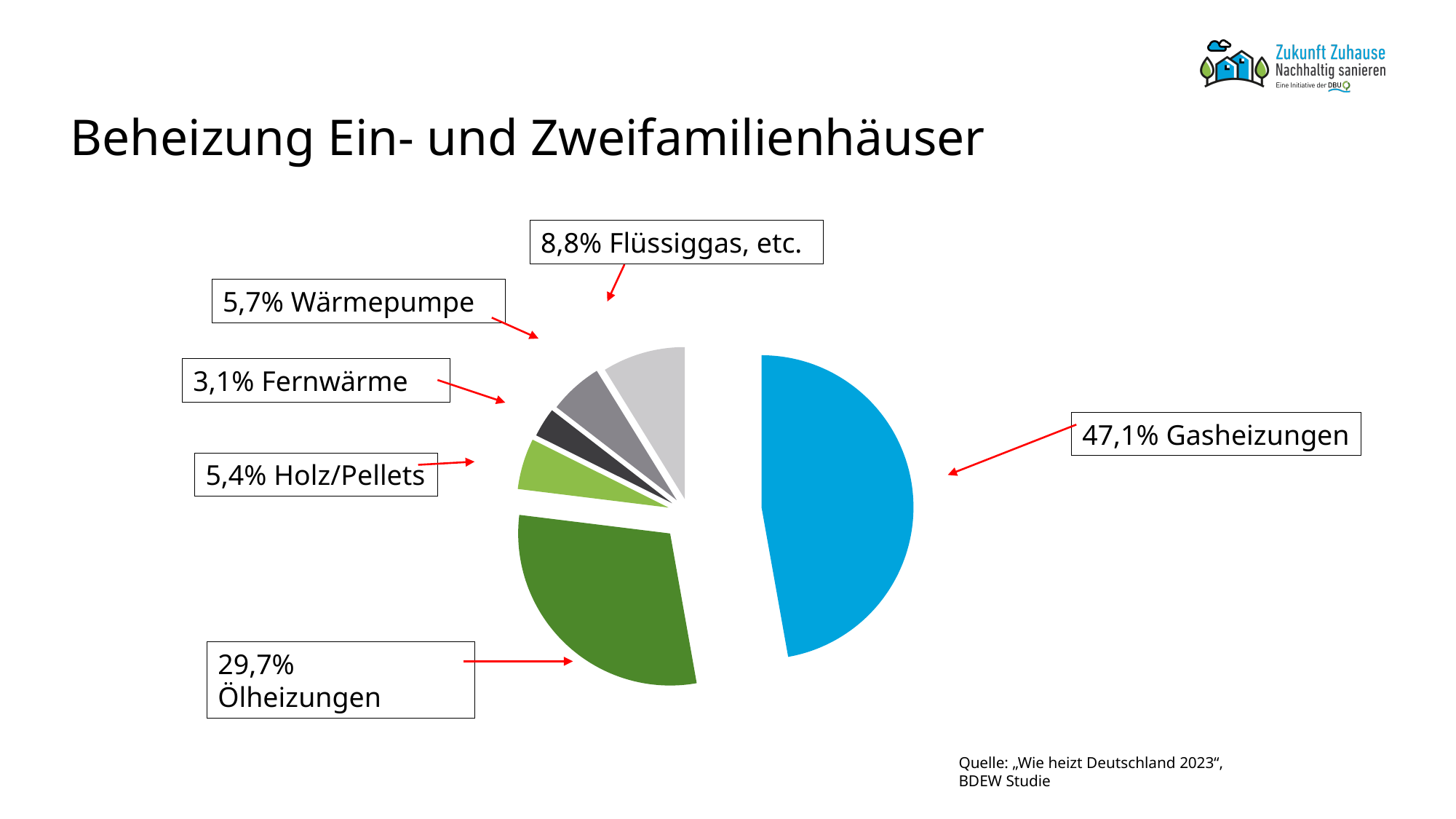
Which category has the smallest slice of the pie chart? Fernwärme What type of chart is shown on the slide? Pie chart What percentage is given for Fernwärme? 3,1% What is the value shown for Wärmepumpe in the pie chart? 5,7% How many slices does the pie chart have? 6 What is the difference between the shares of Flüssiggas, etc. and Wärmepumpe? 3,1% What is the title of the slide containing the chart? Beheizung Ein- und Zweifamilienhäuser What percentage does the pie chart show for Ölheizungen? 29,7% Which category has the largest slice of the pie chart? Gasheizungen Which has a larger share, Wärmepumpe or Holz/Pellets? Wärmepumpe What share of the pie chart is labelled Gasheizungen? 47,1% What is the difference in percentage points between Gasheizungen and Ölheizungen? 17,4%